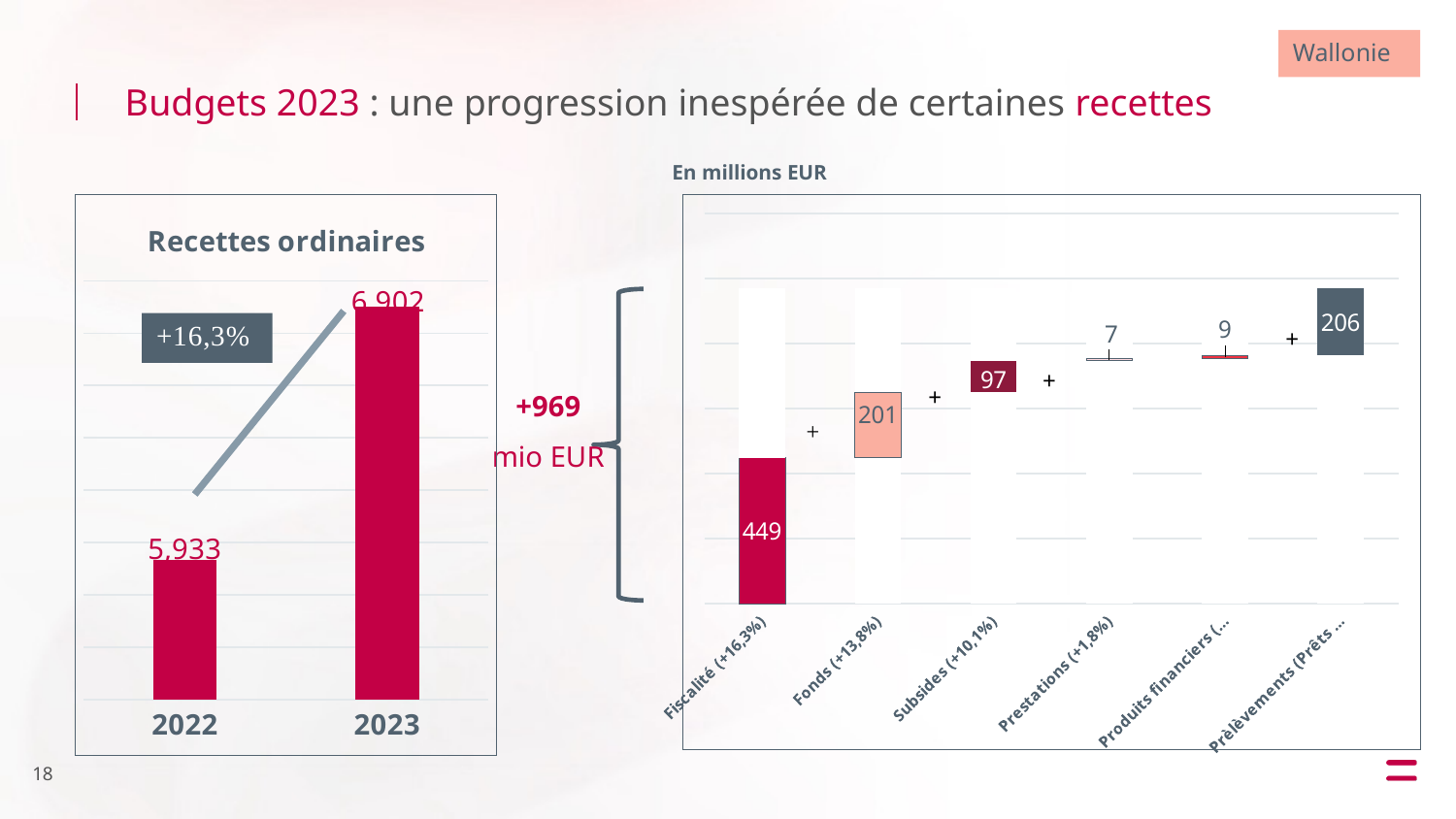
In the right-hand chart (En millions EUR), what is the value for Subsides (+10,1%)? 97 How many categories are shown in the right-hand chart (En millions EUR)? 6 In the right-hand chart (En millions EUR), which category has the lowest value? Prestations (+1,8%) In the 'Recettes ordinaires' chart, what is the value for 2022? 5,933 In the 'Recettes ordinaires' chart, which year has the higher value? 2023 In the 'Recettes ordinaires' chart, what percentage change is shown between 2022 and 2023? +16,3% What kind of chart is the 'Recettes ordinaires' chart on the left? bar chart In the 'Recettes ordinaires' chart, what is the value for 2023? 6,902 In the 'Recettes ordinaires' chart, what is the difference between the 2023 and 2022 values? 969 In the right-hand chart (En millions EUR), what is the value for Fonds (+13,8%)? 201 In the right-hand chart (En millions EUR), which category has the highest value? Fiscalité (+16,3%) In the right-hand chart (En millions EUR), what is the value for Fiscalité (+16,3%)? 449